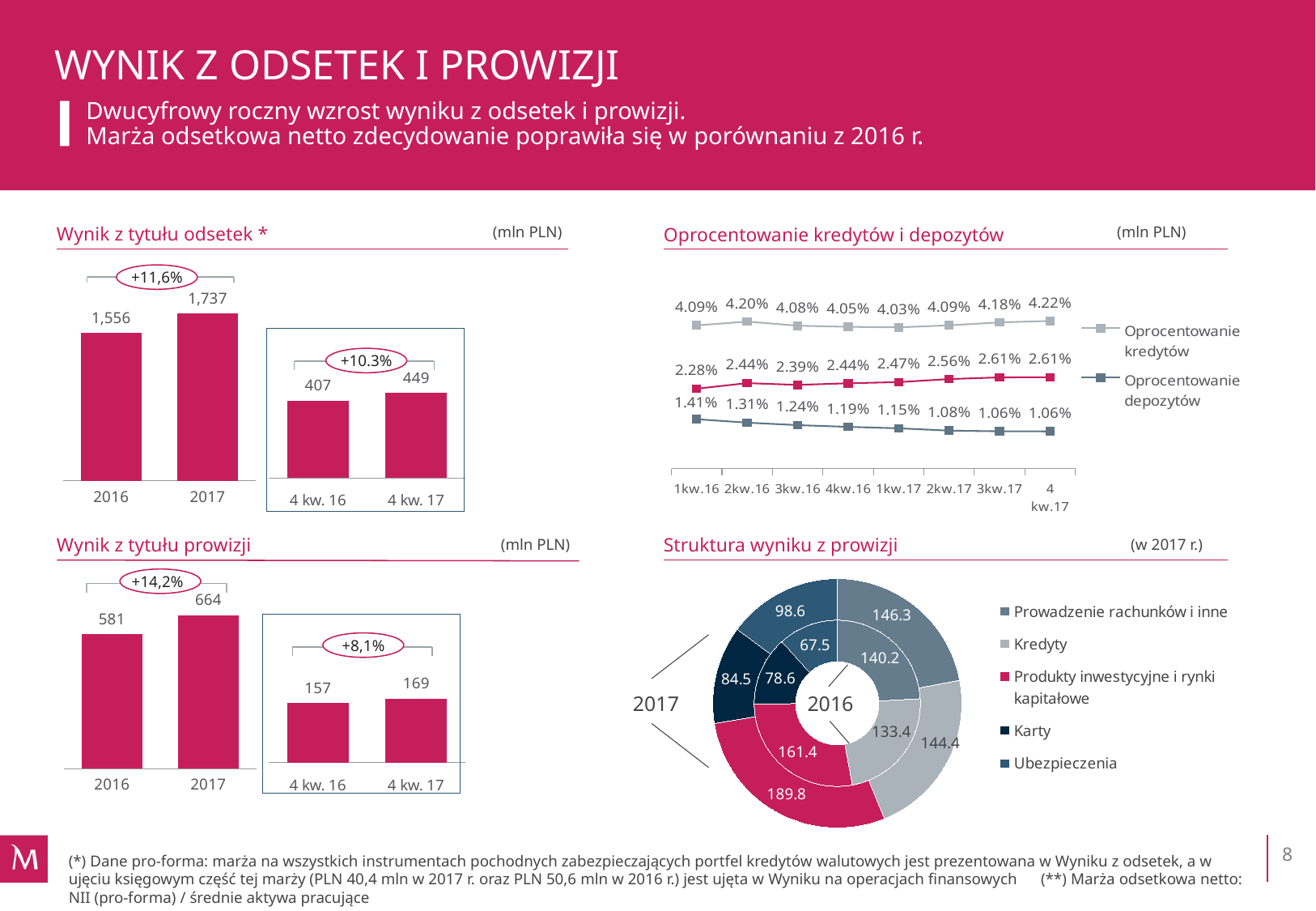
In the 'Oprocentowanie kredytów i depozytów' chart, what is the value of Oprocentowanie kredytów for 4 kw.17? 4.22% How many quarters are plotted on the x axis of the 'Oprocentowanie kredytów i depozytów' chart? 8 In the 'Struktura wyniku z prowizji' chart, what is the 2017 value for Produkty inwestycyjne i rynki kapitałowe? 189.8 In the 'Wynik z tytułu odsetek' chart, what is the difference between the 2017 and 2016 values? 181 In the 'Wynik z tytułu prowizji' chart, what percentage growth is shown between 2016 and 2017? +14,2% In the 'Oprocentowanie kredytów i depozytów' chart, does Oprocentowanie depozytów rise or fall from 1kw.16 to 4 kw.17? fall In the 'Wynik z tytułu prowizji' chart, which is larger, 4 kw. 16 or 4 kw. 17? 4 kw. 17 In the 'Wynik z tytułu odsetek' chart, what is the value for 2017? 1,737 In the 'Oprocentowanie kredytów i depozytów' chart, what is the value of Oprocentowanie depozytów for 1kw.16? 1.41% In the 'Wynik z tytułu odsetek' chart, what is the value for 4 kw. 16? 407 In the 'Wynik z tytułu prowizji' chart, what is the value for 2016? 581 What type of chart is 'Struktura wyniku z prowizji'? doughnut chart